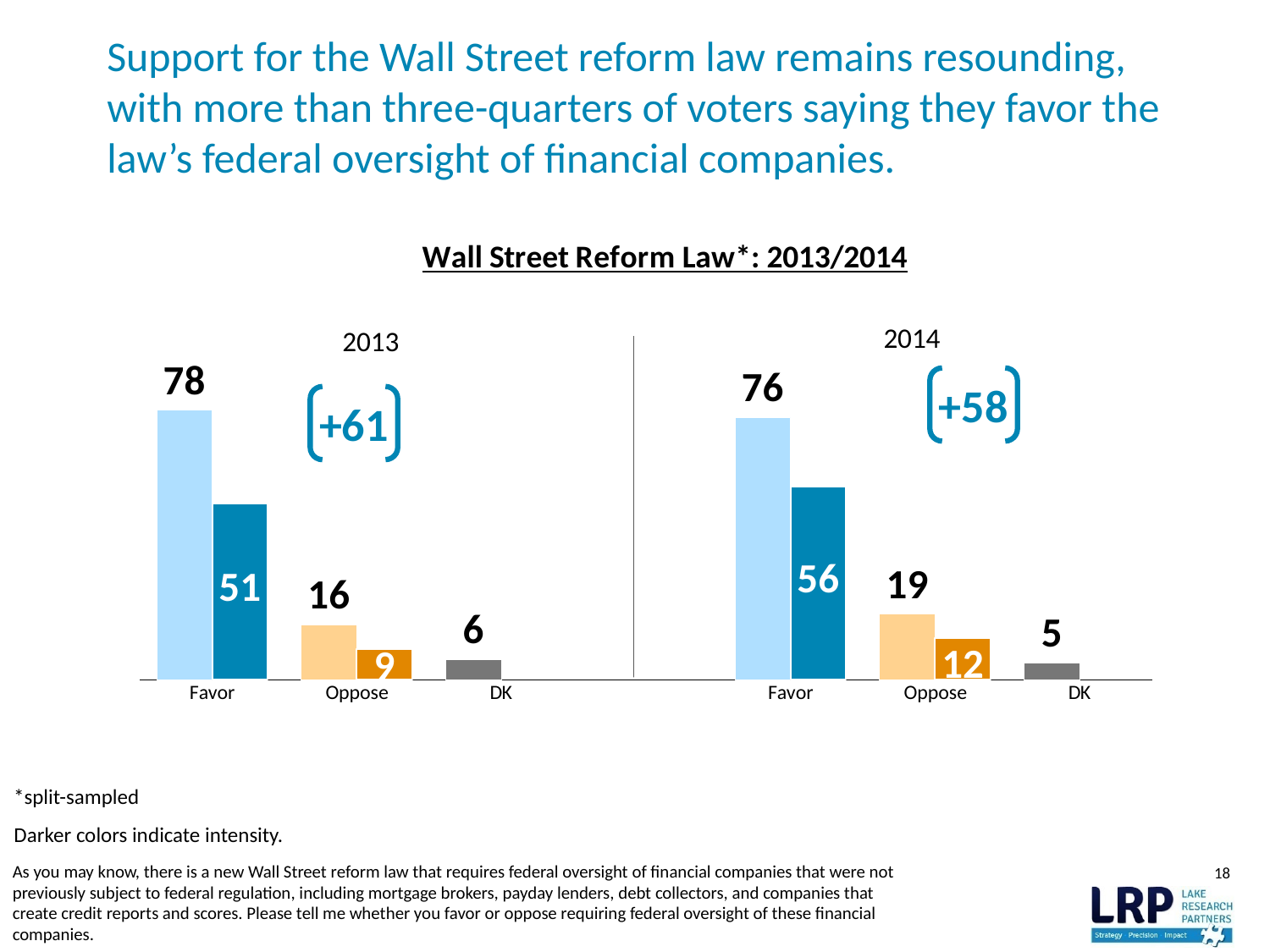
In the 2013 panel, what is the value of the darker Oppose bar? 9 Which category has the highest value in the 2014 panel? Favor How many categories are shown on the x axis of each panel? 3 What type of chart is shown on the slide? Bar chart Which category has the lowest value in the 2013 panel? DK In the 2014 panel, what is the value of the darker Favor bar (intensity)? 56 In the 2013 panel, what percentage of voters favor the Wall Street reform law? 78 What is the difference between the Favor values for 2013 and 2014? 2 In the 2014 panel, what is the value for Oppose? 19 What is the DK value in the 2014 panel? 5 Is the Oppose value larger in 2013 or in 2014? 2014 What is the net margin shown in brackets for 2013? +61